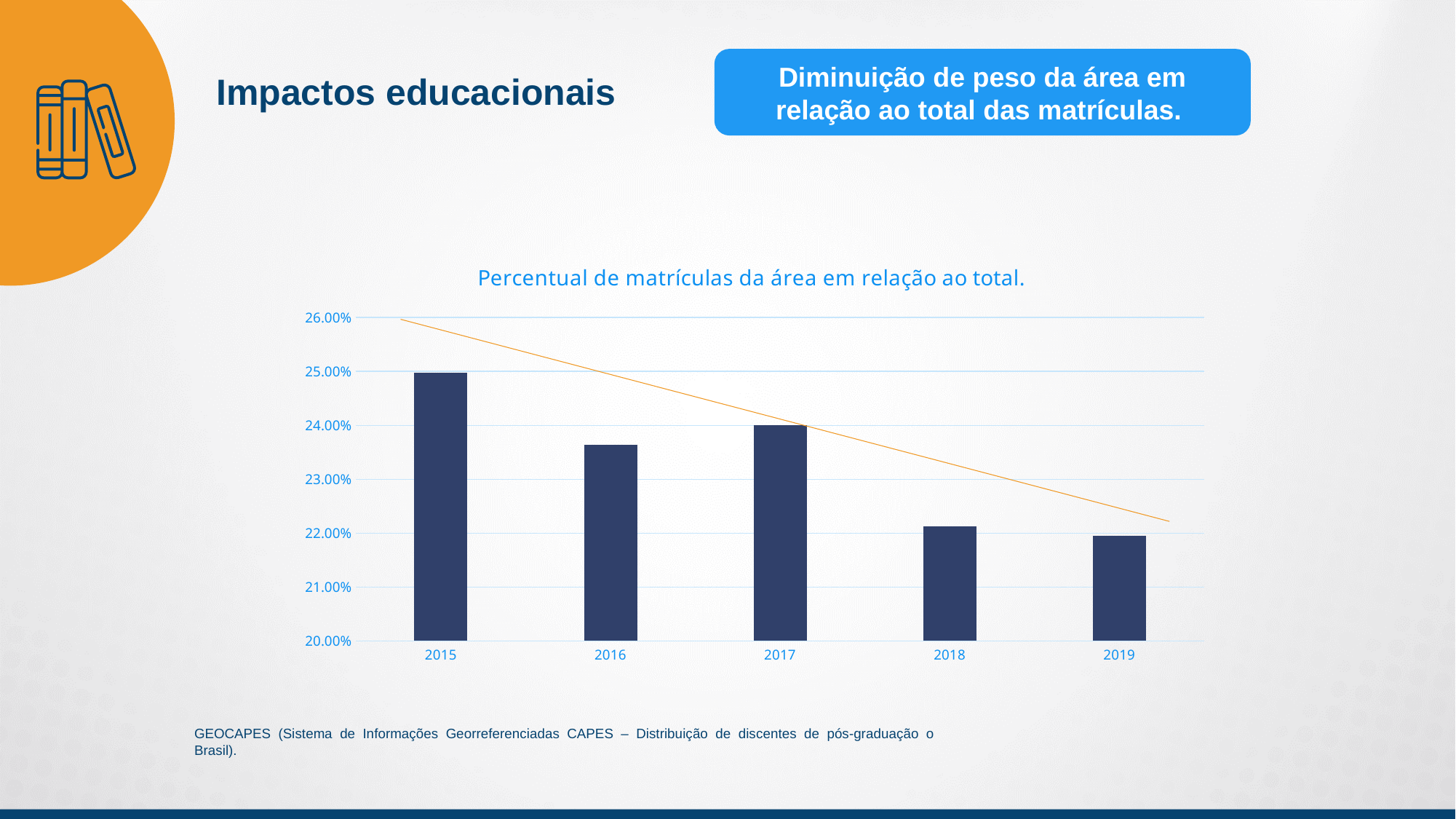
Is the value for 2018 greater or less than 22.00%? greater Do the values generally rise or fall from 2015 to 2019? fall Is the value for 2016 greater or less than 24.00%? less Which year has the highest percentage of enrolments in the chart? 2015 Which year has the larger value, 2015 or 2018? 2015 Is the value for 2015 greater or less than 24.00%? greater How many years are plotted on the x axis of the chart? 5 What kind of chart is shown on the slide? bar chart Which year has the larger value, 2016 or 2017? 2017 What is the title of the chart? Percentual de matrículas da área em relação ao total. Which year has the lowest percentage of enrolments in the chart? 2019